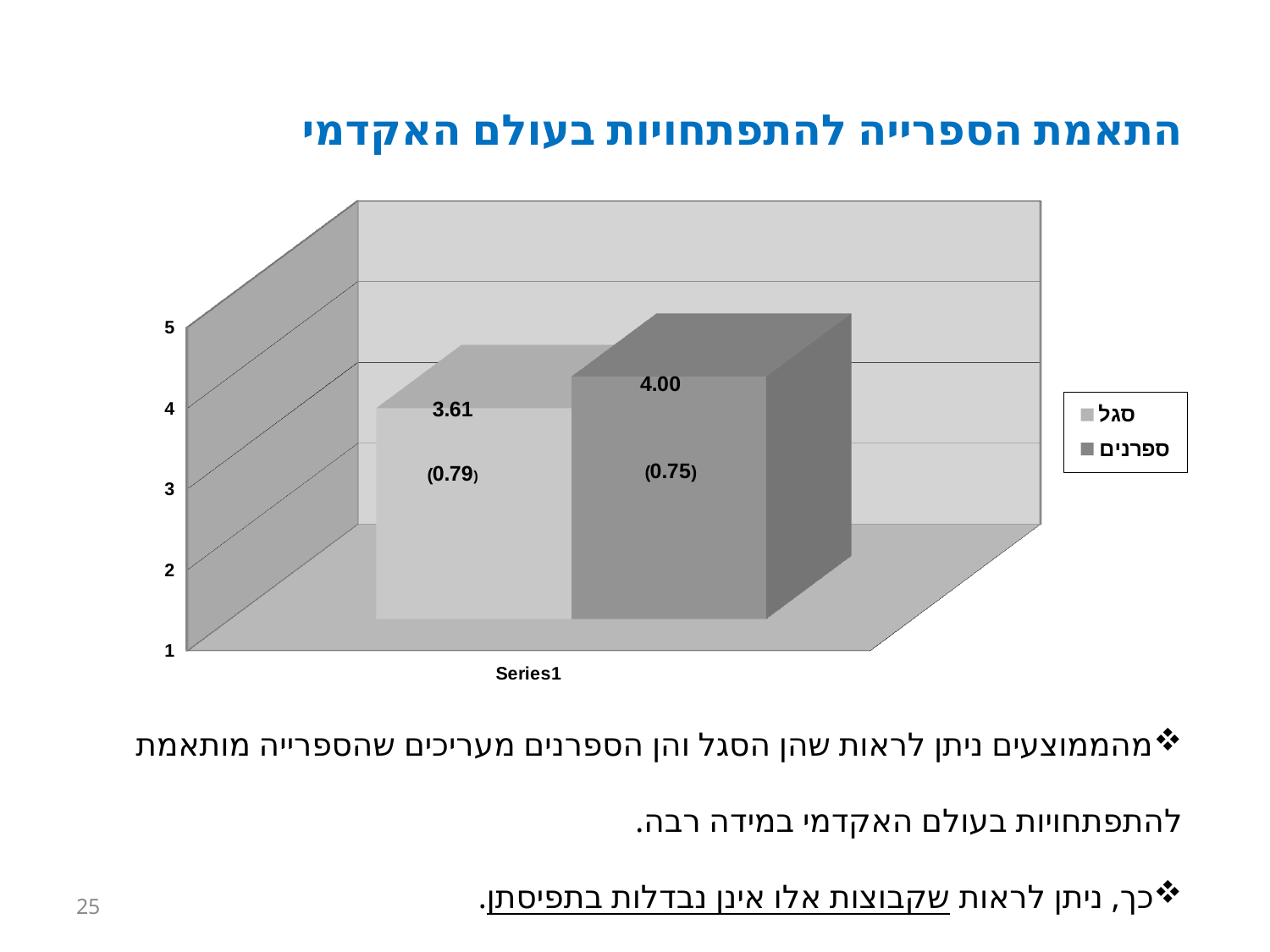
Which series has the higher value, סגל or ספרנים? ספרנים Is the value for סגל greater or less than 4? less What is the value shown for ספרנים? 4.00 Is the value for ספרנים greater or less than 3? greater What is the title of the chart? התאמת הספרייה להתפתחויות בעולם האקדמי How many series does the legend list? 2 Which series has the lower value, סגל or ספרנים? סגל What is the value shown for סגל? 3.61 What kind of chart is shown on the slide? bar chart What is the difference between the value for ספרנים and the value for סגל? 0.39 What value is shown in parentheses below the 4.00 label for ספרנים? (0.75) What value is shown in parentheses below the 3.61 label for סגל? (0.79)